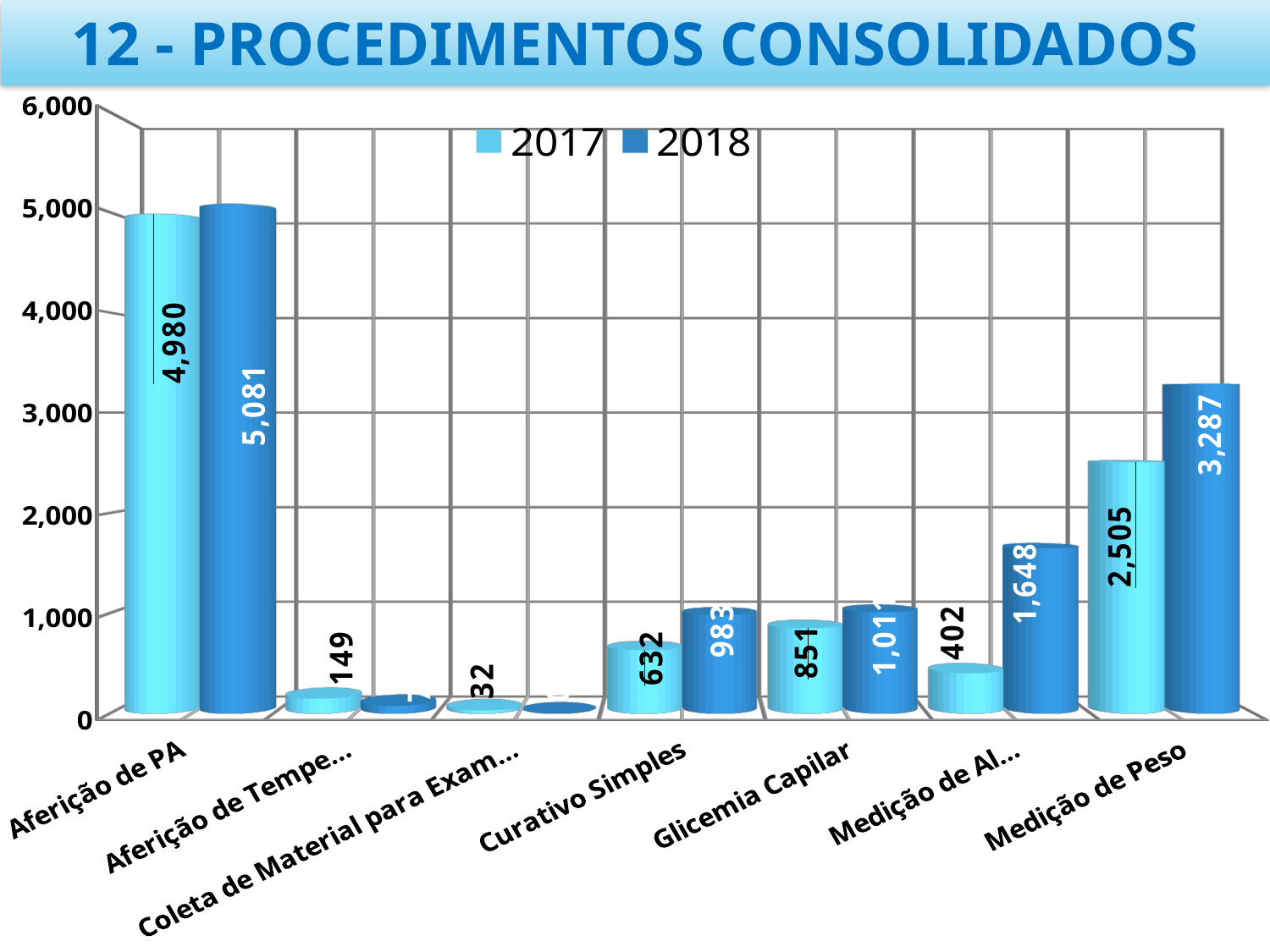
What is the 2017 value for Curativo Simples? 632 What is the 2018 value for Curativo Simples? 983 How many categories are shown on the x axis? 7 What is the 2017 value for Medição de Peso? 2,505 What is the 2018 value for Medição de Peso? 3,287 What is the 2017 value for Glicemia Capilar? 851 How many series does the legend list? 2 What is the 2017 value for Aferição de PA? 4,980 Which is larger for Curativo Simples, the 2017 value or the 2018 value? 2018 Which category has the highest 2018 value? Aferição de PA What kind of chart is shown on the slide? Bar chart What is the difference between the 2018 and 2017 values for Medição de Peso? 782